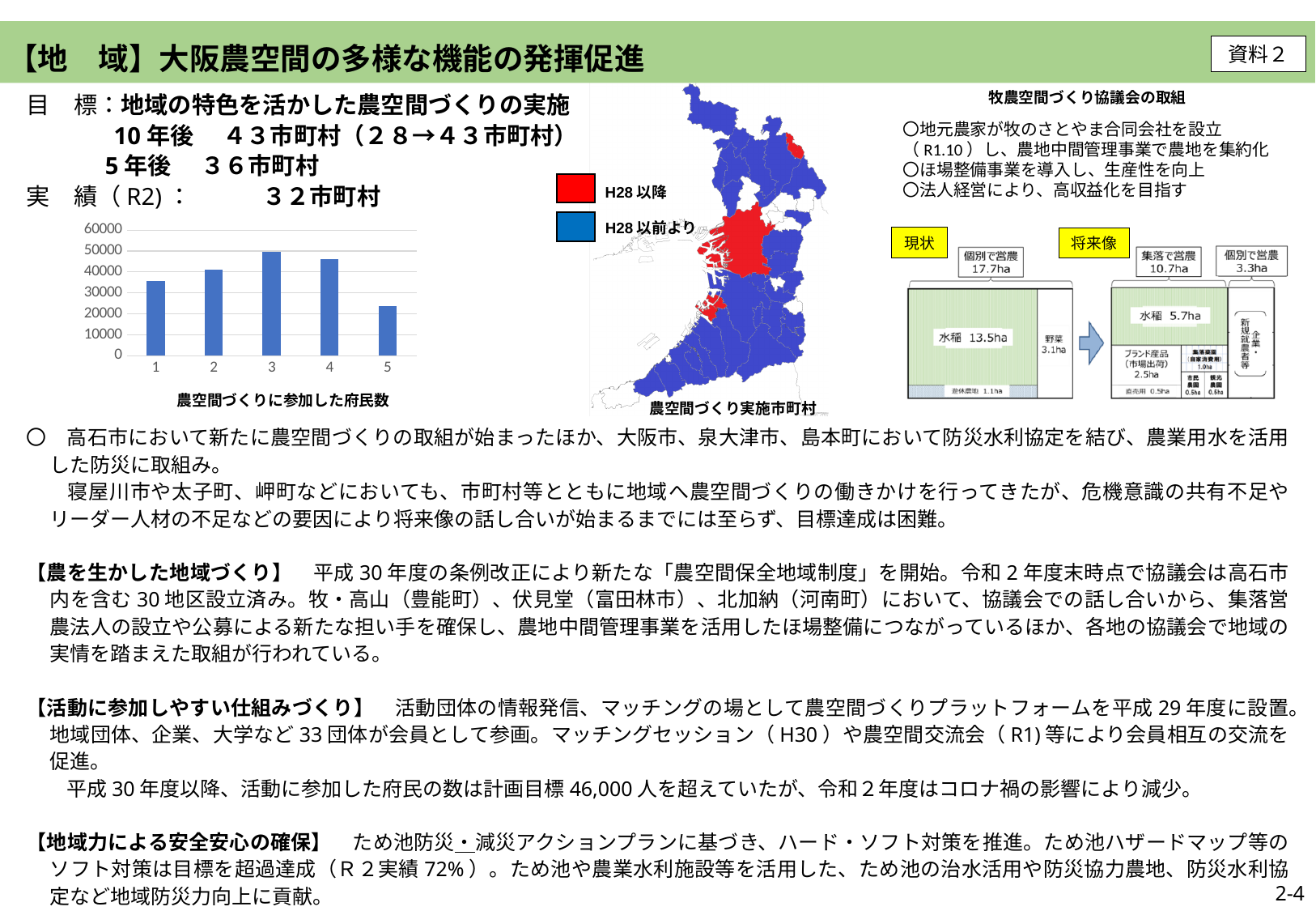
In the chart 農空間づくりに参加した府民数, is the value for category 1 greater or less than 30000? greater In the chart 農空間づくりに参加した府民数, which is larger, the value for category 4 or category 5? 4 What is the title printed below the bar chart on the left of the slide? 農空間づくりに参加した府民数 How many bars does the chart 農空間づくりに参加した府民数 have? 5 In the chart 農空間づくりに参加した府民数, which category has the highest bar? 3 What kind of chart is shown under the heading 農空間づくりに参加した府民数? bar chart In the chart 農空間づくりに参加した府民数, is the value for category 5 greater or less than 30000? less In the chart 農空間づくりに参加した府民数, which category has the lowest bar? 5 What is the highest value shown on the vertical axis of the chart 農空間づくりに参加した府民数? 60000 In the chart 農空間づくりに参加した府民数, is the value for category 3 greater or less than 40000? greater In the chart 農空間づくりに参加した府民数, which is larger, the value for category 1 or category 2? 2